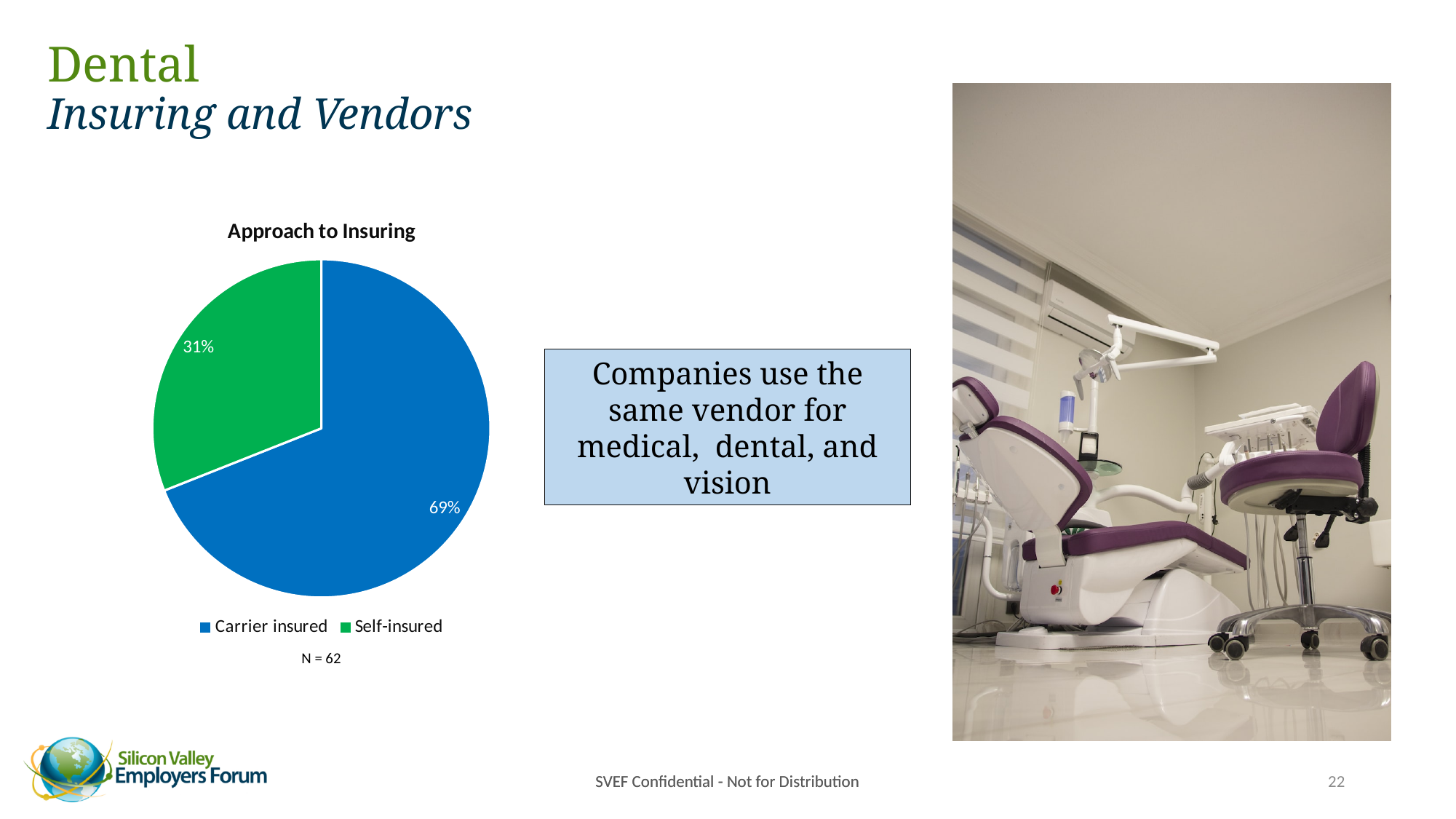
Which is larger, the Carrier insured slice or the Self-insured slice? Carrier insured What is the difference in percentage points between Carrier insured and Self-insured? 38 How many slices does the pie chart have? 2 What type of chart is shown under the title "Approach to Insuring"? Pie chart What is the sample size (N) noted below the pie chart? N = 62 What is the title of the pie chart? Approach to Insuring What colour is the Self-insured slice in the pie chart? Green What percentage of the pie is Self-insured? 31% Which slice of the pie is the smallest? Self-insured How many entries does the legend of the pie chart list? 2 What percentage of the pie is Carrier insured? 69% Which slice of the pie is the largest? Carrier insured